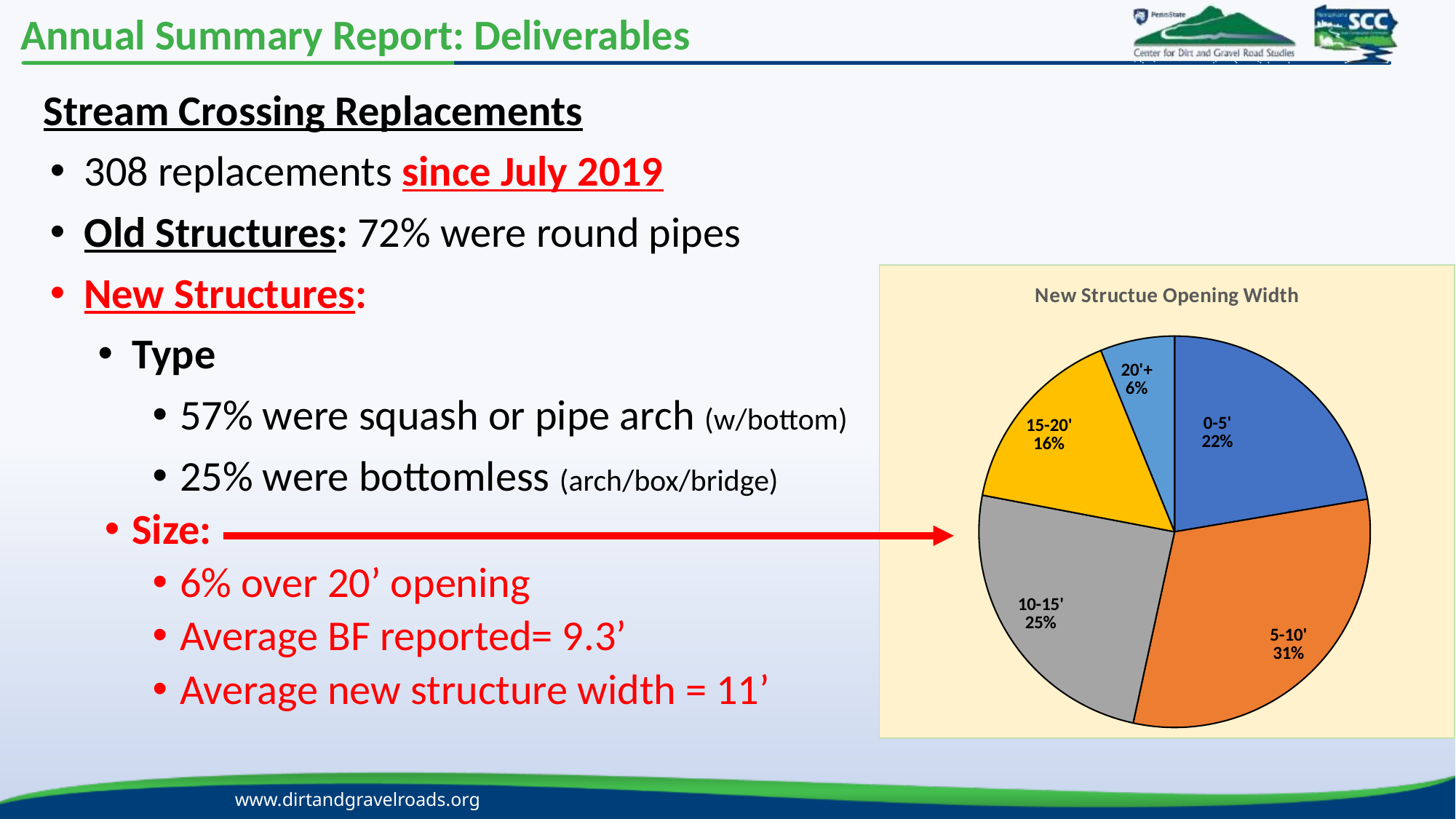
How many categories are shown in the pie chart? 5 Which opening width category has the largest share of the pie? 5-10' What percentage is shown for the 0-5' category? 22% What colour is the 10-15' slice? Gray What is the title of the chart? New Structue Opening Width What percentage is shown for the 20'+ category? 6% Which slice is larger, 0-5' or 15-20'? 0-5' What type of chart is shown on the slide? Pie chart What percentage is shown for the 15-20' category? 16% What is the difference in percentage points between the 5-10' and 10-15' slices? 6 Which opening width category has the smallest share of the pie? 20'+ What share of the pie does the 5-10' slice represent? 31%